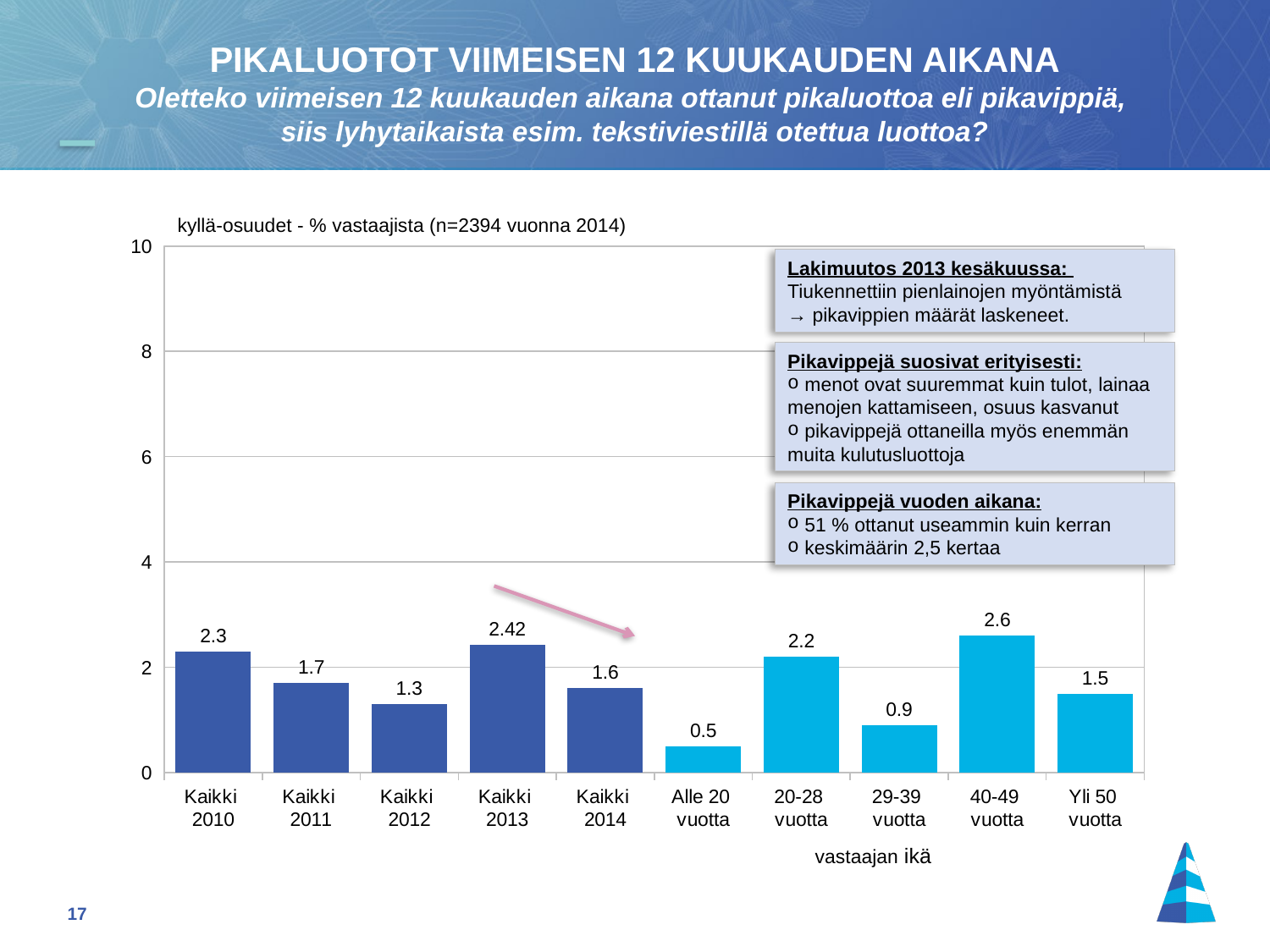
What is the x-axis label shown under the age group bars? vastaajan ikä What is the value for Alle 20 vuotta? 0.5 How many categories are shown on the x axis? 10 What is the difference between the values for Kaikki 2013 and Kaikki 2014? 0.82 Do the values for Kaikki rise or fall from 2010 to 2012? fall Is the value for 29-39 vuotta greater or less than 2? less What is the value for Kaikki 2013? 2.42 What kind of chart is this? bar chart Which category has the lowest value? Alle 20 vuotta What is the value for 40-49 vuotta? 2.6 Which is larger, the value for Kaikki 2010 or the value for 20-28 vuotta? Kaikki 2010 Which category has the highest value? 40-49 vuotta